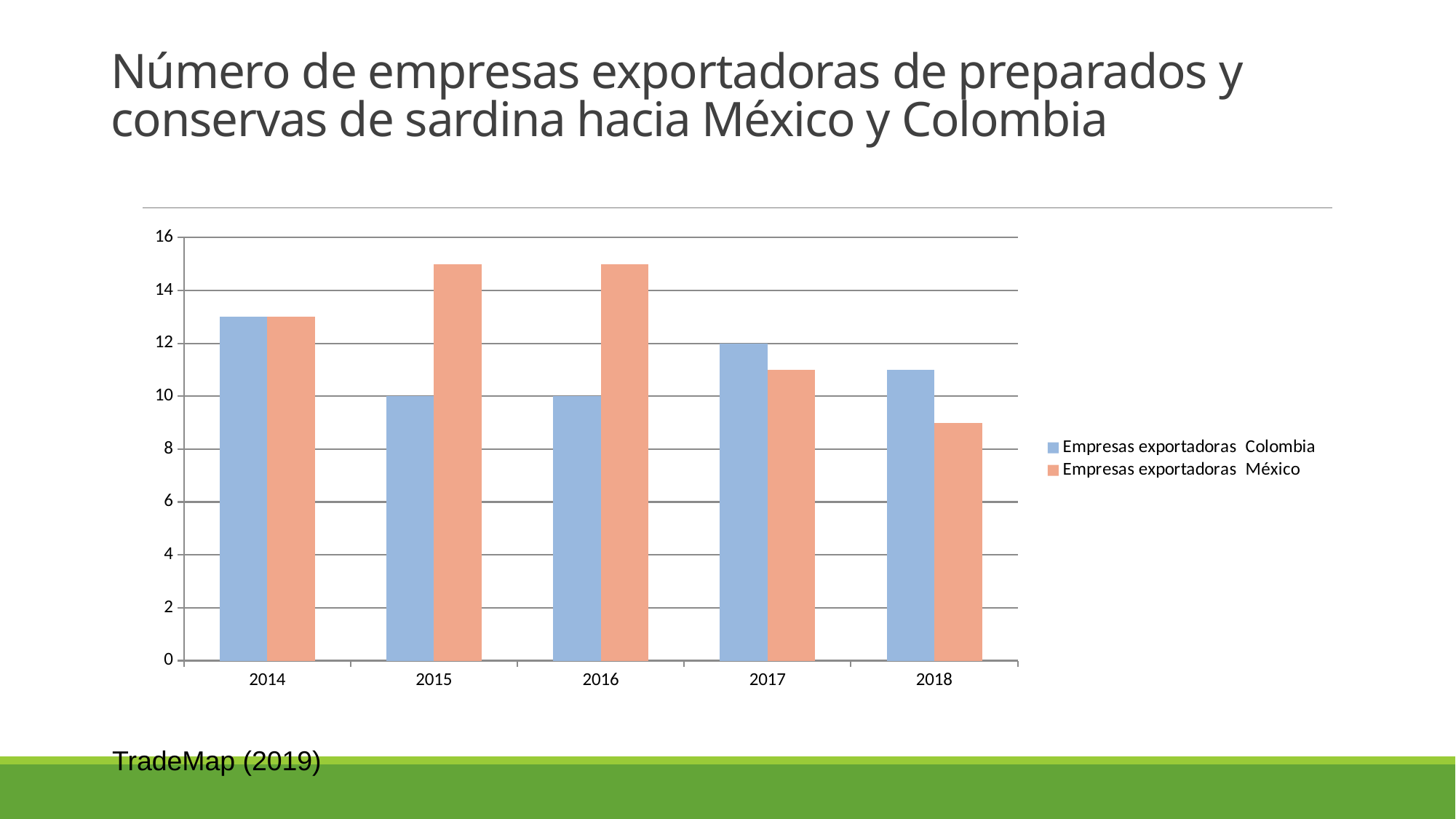
What is the value for Empresas exportadoras Colombia in 2017? 12 Do the values for Empresas exportadoras México rise or fall from 2016 to 2018? fall In which year is the value for Empresas exportadoras México lowest? 2018 What is the value for Empresas exportadoras Colombia in 2015? 10 In which year is the value for Empresas exportadoras Colombia highest? 2014 Is the value for Empresas exportadoras México in 2018 greater or less than 10? less What is the difference between the Colombia values for 2017 and 2015? 2 Is the value for Empresas exportadoras México in 2015 greater or less than 14? greater How many years are shown on the x axis? 5 How many series does the legend list? 2 In 2018, which series has the larger value, Colombia or México? Colombia What type of chart is shown on the slide? bar chart